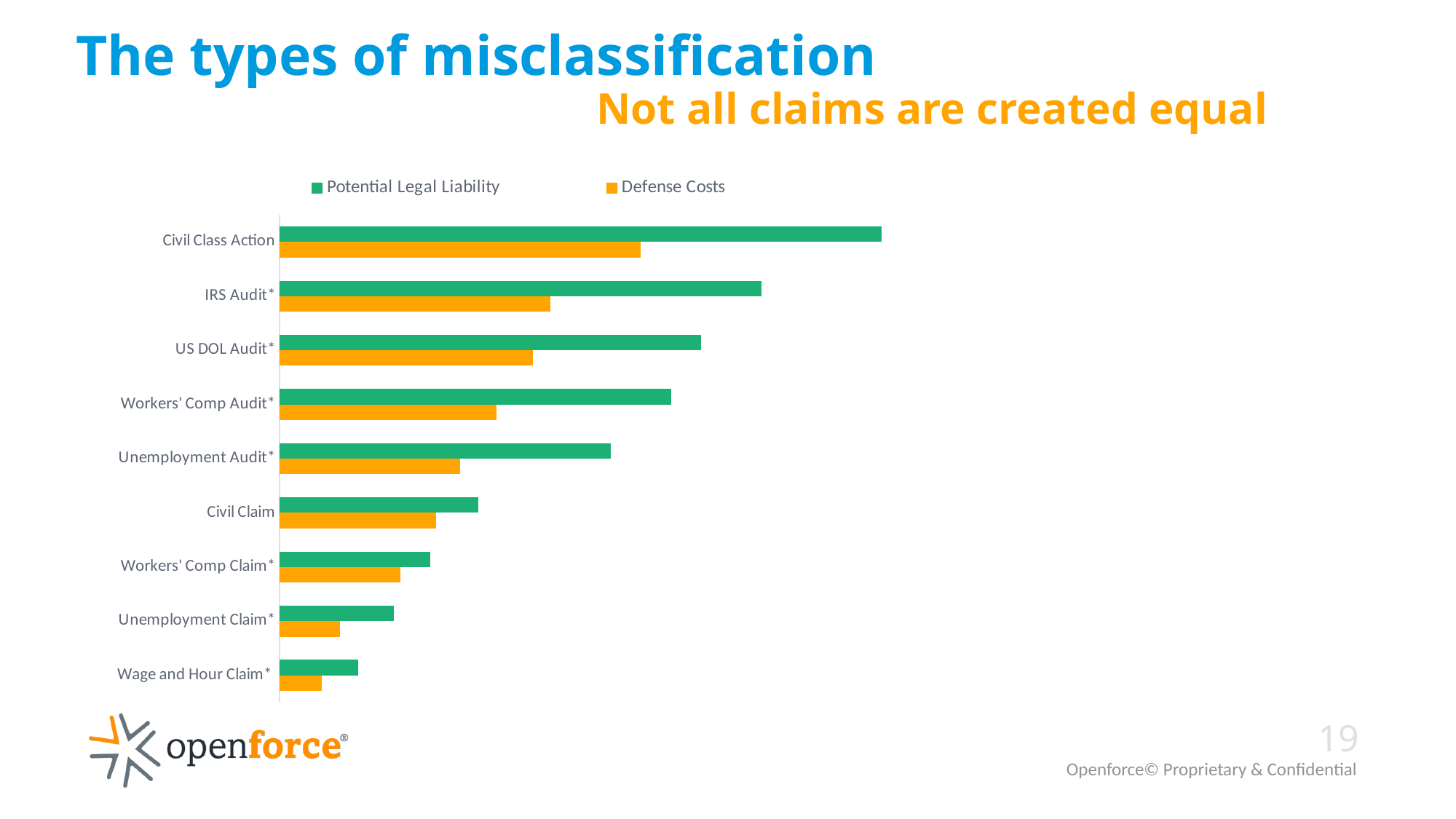
Which claim type has the highest Defense Costs? Civil Class Action How many claim types (categories) are plotted on the chart? 9 Which claim type has the lowest Defense Costs? Wage and Hour Claim* Which has the larger Defense Costs, Workers' Comp Claim* or Unemployment Claim*? Workers' Comp Claim* For Civil Class Action, which is larger: Potential Legal Liability or Defense Costs? Potential Legal Liability Which colour represents Defense Costs in the chart? Orange How many series does the legend list? 2 Do the Potential Legal Liability bars increase or decrease going from the top category to the bottom category? Decrease Which has the larger Potential Legal Liability, IRS Audit* or US DOL Audit*? IRS Audit* Which claim type has the highest Potential Legal Liability? Civil Class Action What kind of chart is shown on the slide? Bar chart Which claim type has the lowest Potential Legal Liability? Wage and Hour Claim*